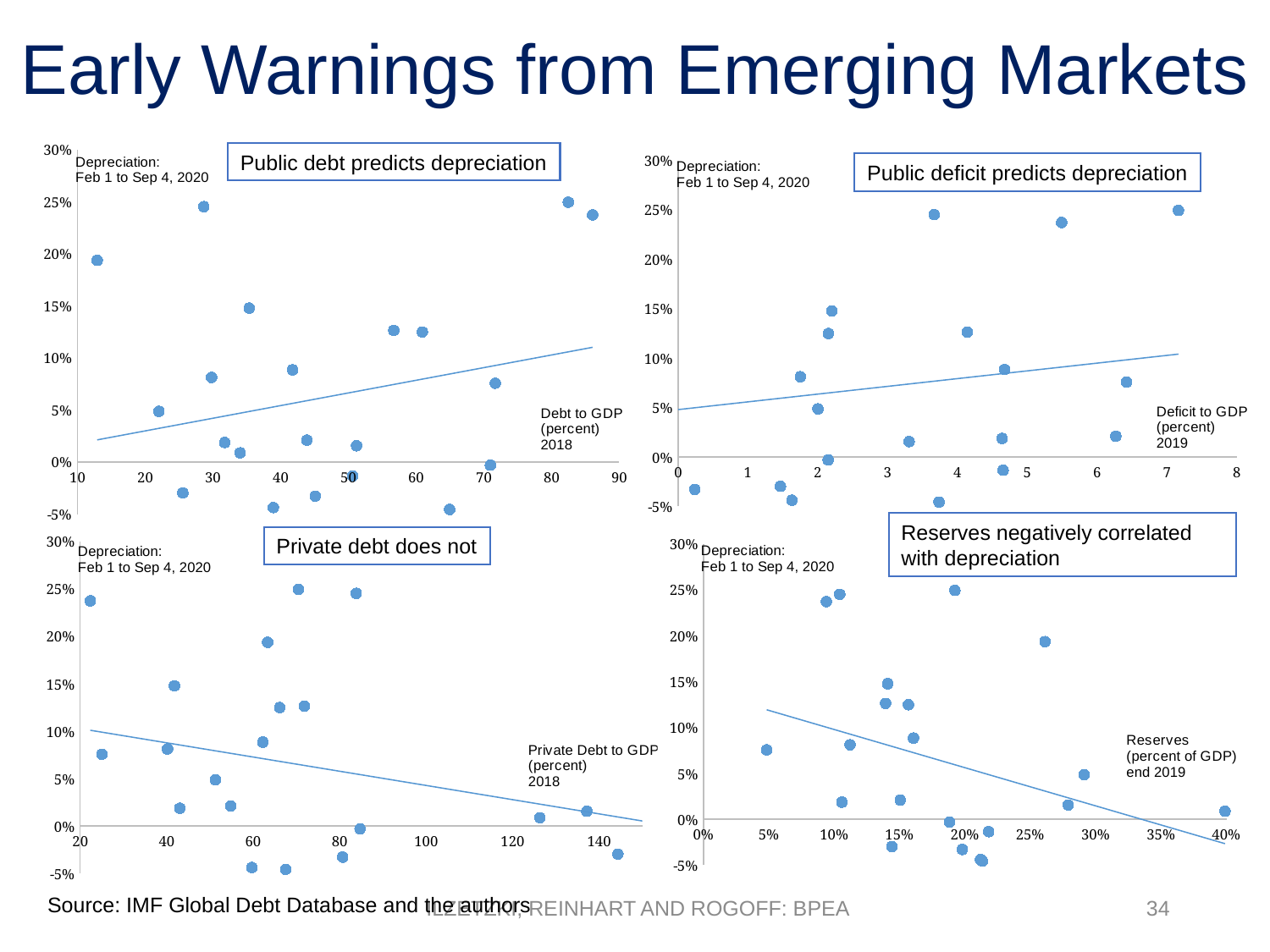
In the 'Reserves negatively correlated with depreciation' chart, is the depreciation for the point at about 40% reserves greater or less than 5%? less In the 'Public debt predicts depreciation' chart, does the trend line rise or fall as debt to GDP increases? rises In the 'Private debt does not' chart, does the trend line rise or fall as private debt to GDP increases? falls In the 'Private debt does not' chart, is the depreciation for the point with the highest private debt (around 140) greater or less than 0%? less In the 'Reserves negatively correlated with depreciation' chart, does the trend line rise or fall as reserves increase? falls In the 'Public debt predicts depreciation' chart, is the highest depreciation value plotted greater or less than 20%? greater What kind of chart is the 'Public debt predicts depreciation' chart? scatter chart What is the x-axis label of the 'Public deficit predicts depreciation' chart? Deficit to GDP (percent) 2019 What variable is plotted on the y axis of all four charts? Depreciation: Feb 1 to Sep 4, 2020 How many charts are shown on the slide? 4